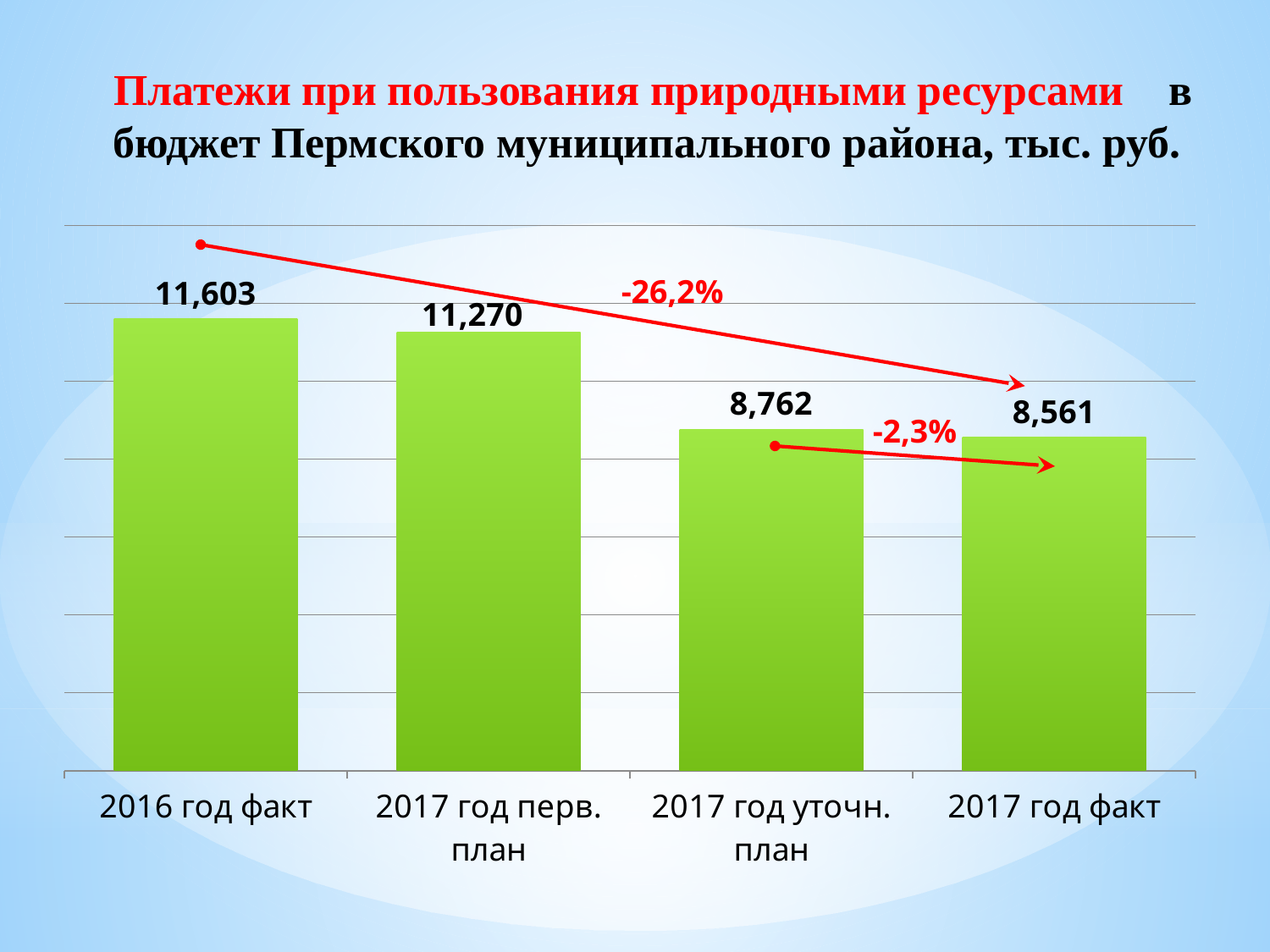
What is the value for 2017 год факт? 8,561 What is the difference between the values for 2017 год уточн. план and 2017 год факт? 201 What is the value for 2017 год перв. план? 11,270 Which category has the lowest value? 2017 год факт How many categories are shown on the chart? 4 Which category has the highest value? 2016 год факт What is the value for 2016 год факт? 11,603 What percentage change is annotated between 2016 год факт and 2017 год факт? -26,2% What is the difference between the values for 2016 год факт and 2017 год факт? 3,042 What kind of chart is shown on the slide? bar chart What is the value for 2017 год уточн. план? 8,762 Which is larger, the value for 2017 год перв. план or the value for 2017 год уточн. план? 2017 год перв. план